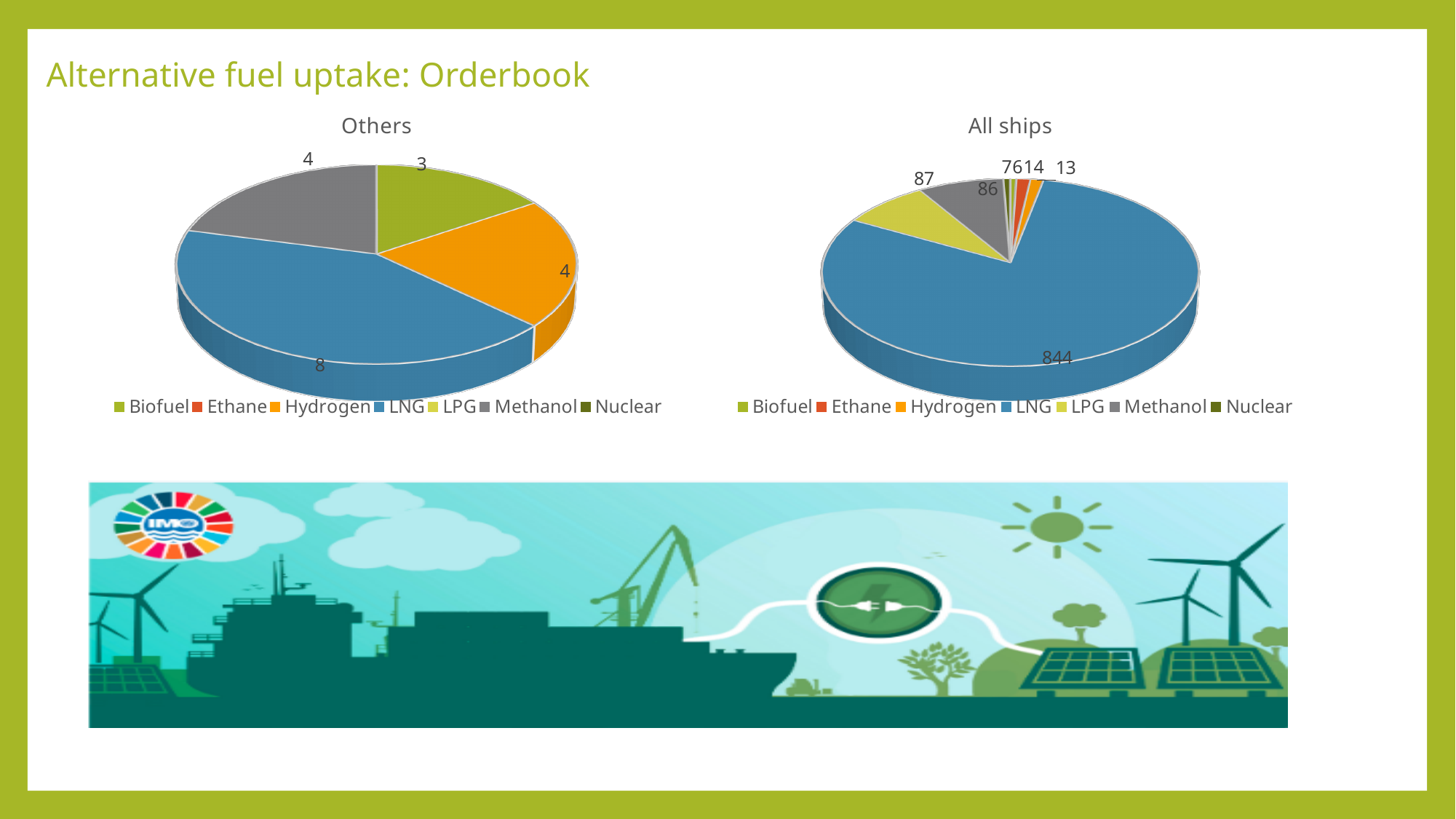
In the "All ships" chart, what is the value for LNG? 844 What kind of chart is the "All ships" chart? Pie chart In the "Others" chart, what is the value for Biofuel? 3 In the "Others" chart, which fuel has the largest slice? LNG In the "Others" chart, what is the value for Hydrogen? 4 In the "Others" chart, which fuel has the smallest labelled slice? Biofuel In the "Others" chart, what is the value for LNG? 8 In the "All ships" chart, what is the value for LPG? 87 In the "Others" chart, what is the total of the four labelled slices? 19 In the "Others" chart, what is the difference between the LNG value and the Biofuel value? 5 In the "All ships" chart, which is larger, LPG or Methanol? LPG How many fuel types are listed in the legend of the "Others" chart? 7